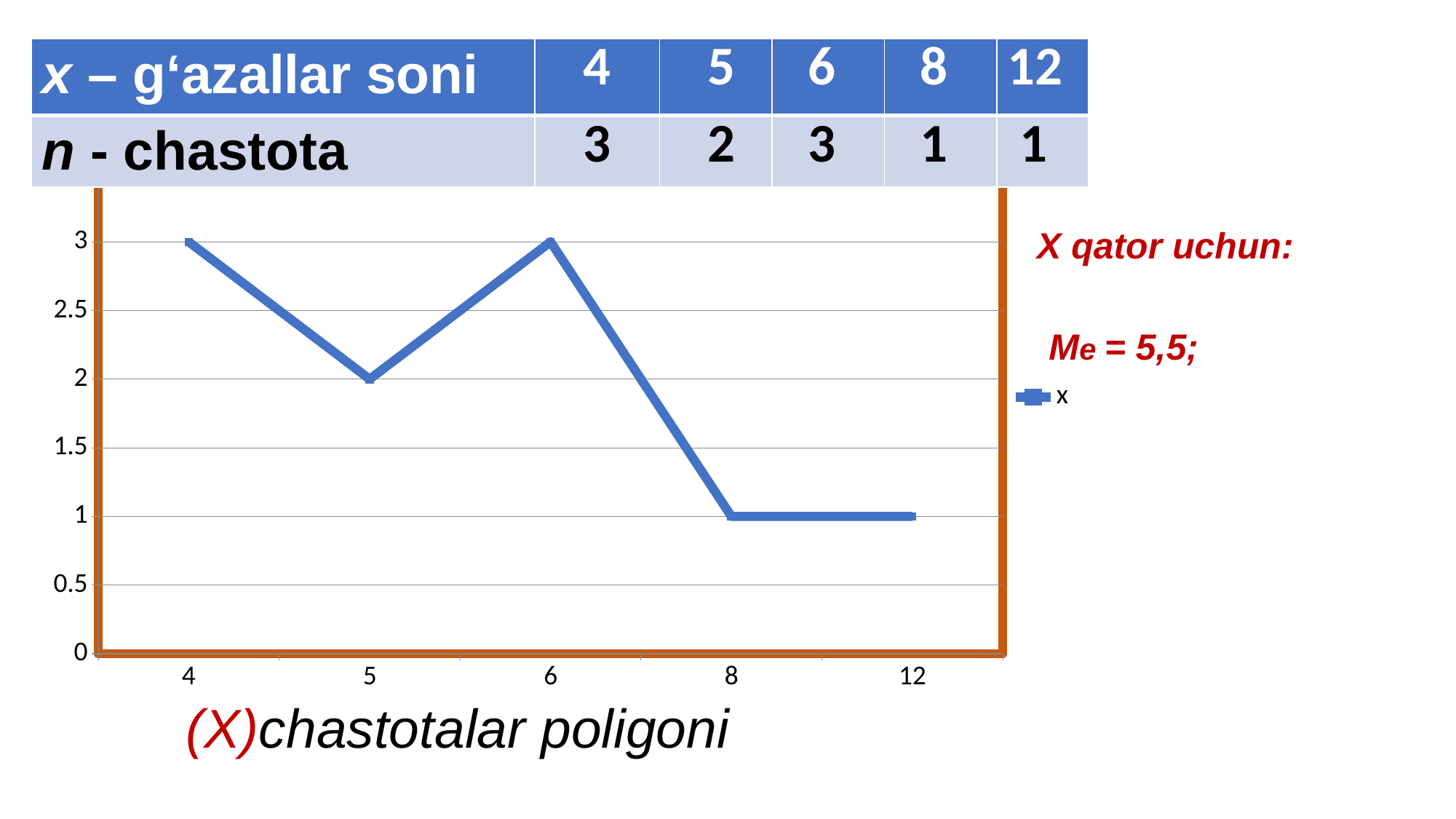
How many points are plotted on the line? 5 What is the plotted value at x = 12? 1 Does the line rise or fall between x = 6 and x = 8? fall What is the name of the series shown in the legend? x Which is larger, the value at x = 4 or the value at x = 5? x = 4 Is the value at x = 5 greater or less than 1.5? greater What type of chart is shown on the slide? line chart How many series does the legend list? 1 What is the plotted value at x = 8? 1 What is the plotted value at x = 4? 3 What is the difference between the values at x = 6 and x = 8? 2 What is the plotted value at x = 5? 2